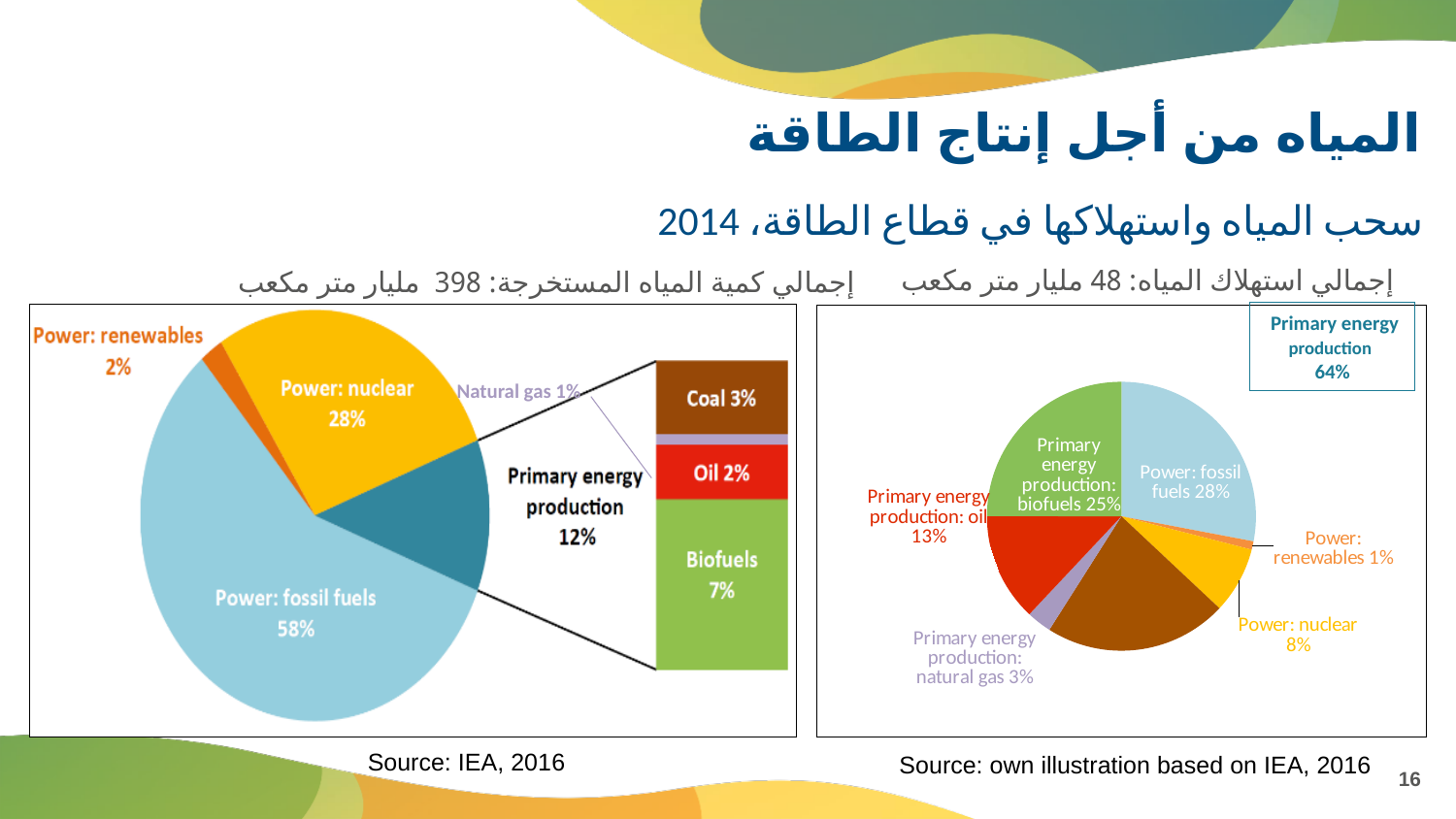
In the left pie chart's breakdown bar, what share is labelled for Biofuels? 7% What kind of chart is shown on the right side of the slide? Pie chart In the right pie chart, which category has the smallest share? Power: renewables In the left pie chart, which category has the largest share? Power: fossil fuels In the right pie chart, what total share is labelled for Primary energy production? 64% In the right pie chart, which is larger: Power: fossil fuels or Primary energy production: oil? Power: fossil fuels In the right pie chart, what share is labelled for Primary energy production: biofuels? 25% In the left pie chart, what share is labelled for Primary energy production? 12% In the left pie chart, what share is labelled for Power: nuclear? 28% In the left pie chart, what share is labelled for Power: fossil fuels? 58% In the left pie chart, what is the difference between the shares for Power: fossil fuels and Power: nuclear? 30% In the right pie chart, what share is labelled for Power: nuclear? 8%